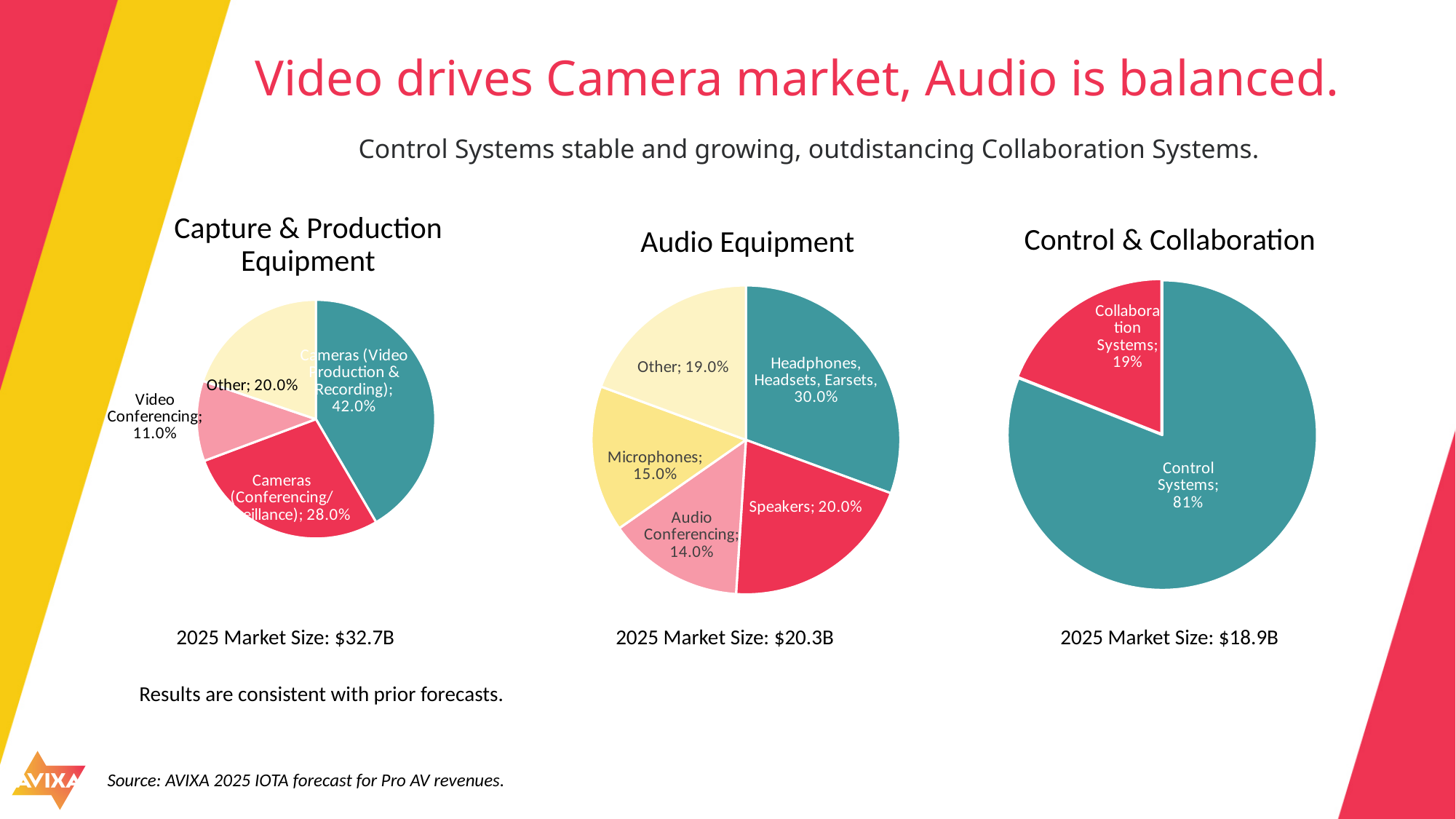
In the Audio Equipment pie chart, what is the value for Headphones, Headsets, Earsets? 30.0% What kind of chart is the Audio Equipment chart? Pie chart In the Capture & Production Equipment pie chart, which category has the smallest slice? Video Conferencing In the Audio Equipment pie chart, how many categories are shown? 5 In the Control & Collaboration pie chart, which is larger, Control Systems or Collaboration Systems? Control Systems In the Capture & Production Equipment pie chart, what share do Cameras (Video Production & Recording) hold? 42.0% In the Audio Equipment pie chart, what is the difference between Headphones, Headsets, Earsets and Speakers? 10.0% In the Capture & Production Equipment pie chart, what is the value for Video Conferencing? 11.0% In the Audio Equipment pie chart, what is the value for Microphones? 15.0% In the Audio Equipment pie chart, which category has the smallest slice? Audio Conferencing In the Capture & Production Equipment pie chart, which category has the largest slice? Cameras (Video Production & Recording) In the Control & Collaboration pie chart, what share do Control Systems hold? 81%